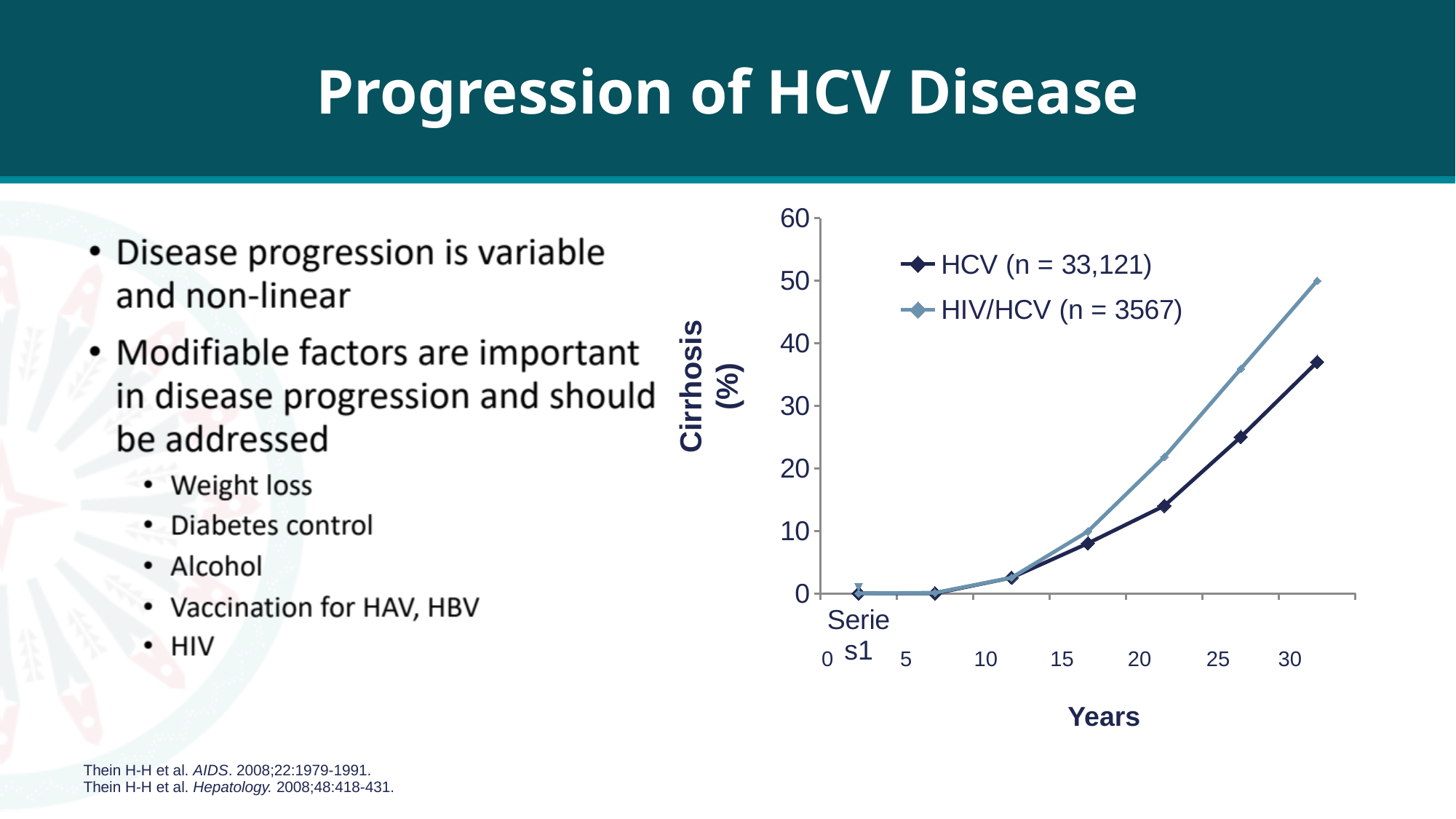
Is the cirrhosis value for the HCV series at 20 years greater or less than 10? greater Do the cirrhosis values for the HIV/HCV series rise or fall as years increase? rise Is the cirrhosis value for the HIV/HCV series at 30 years greater or less than 40? greater At 25 years, which series has the higher cirrhosis percentage, HCV or HIV/HCV? HIV/HCV How many series does the chart legend list? 2 What kind of chart is shown on the slide? line chart Is the cirrhosis value for the HCV series at 30 years greater or less than 40? less Do the cirrhosis values for the HCV series rise or fall as years increase? rise What are the two series named in the chart legend? HCV (n = 33,121) and HIV/HCV (n = 3567) What is the label of the y axis of the chart? Cirrhosis (%) At 30 years, which series has the higher cirrhosis percentage, HCV or HIV/HCV? HIV/HCV